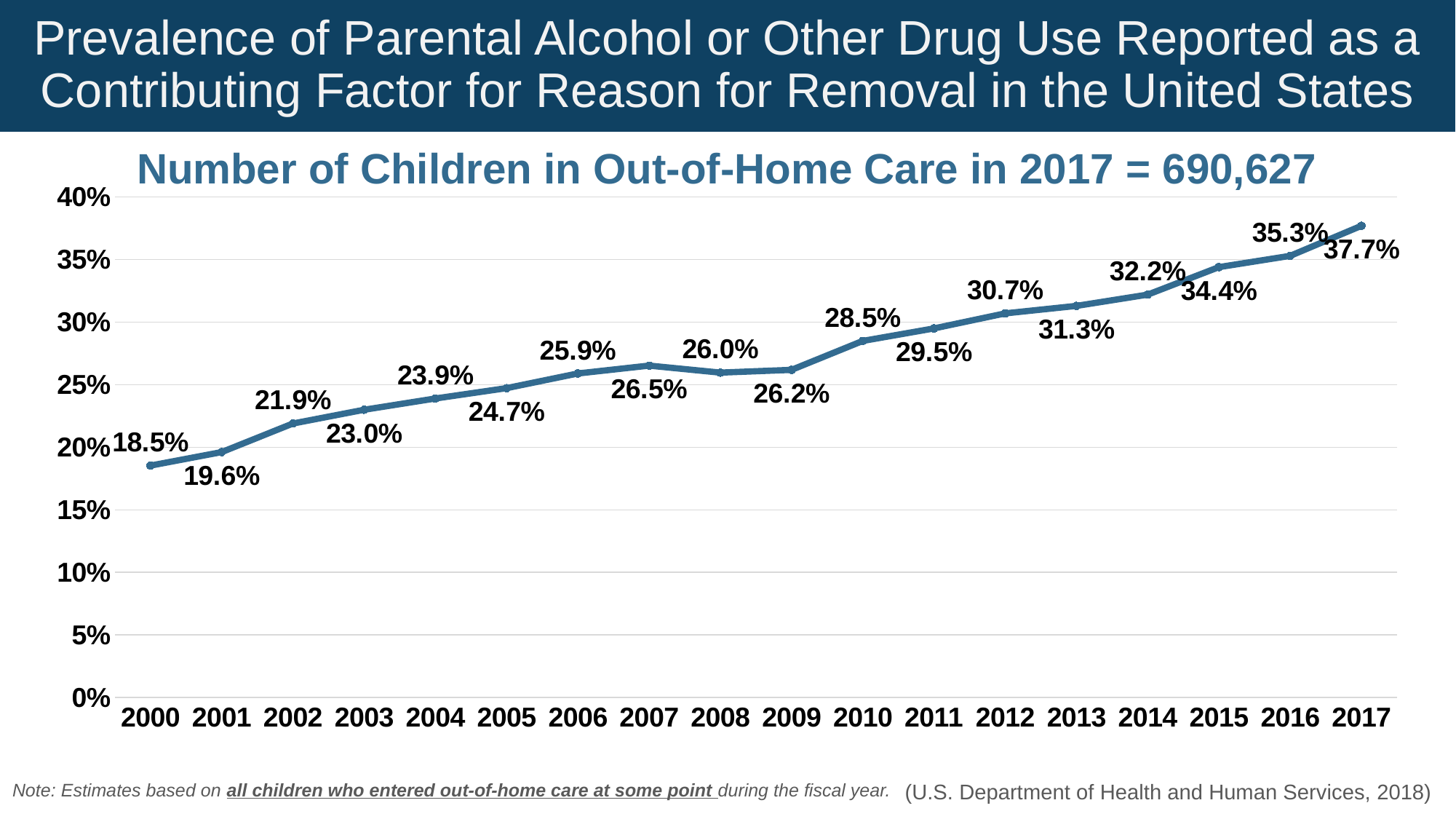
Do the values generally rise or fall from 2000 to 2017? rise How many years are plotted on the x axis? 18 According to the chart subtitle, how many children were in out-of-home care in 2017? 690,627 Which is larger, the value for 2007 or the value for 2008? 2007 Which year has the highest value? 2017 What is the difference between the values for 2017 and 2000? 19.2% What is the value for 2008? 26.0% What kind of chart is shown? line chart Which year has the lowest value? 2000 What is the value for 2000? 18.5% What is the value for 2017? 37.7% Is the value for 2012 greater or less than 30%? greater